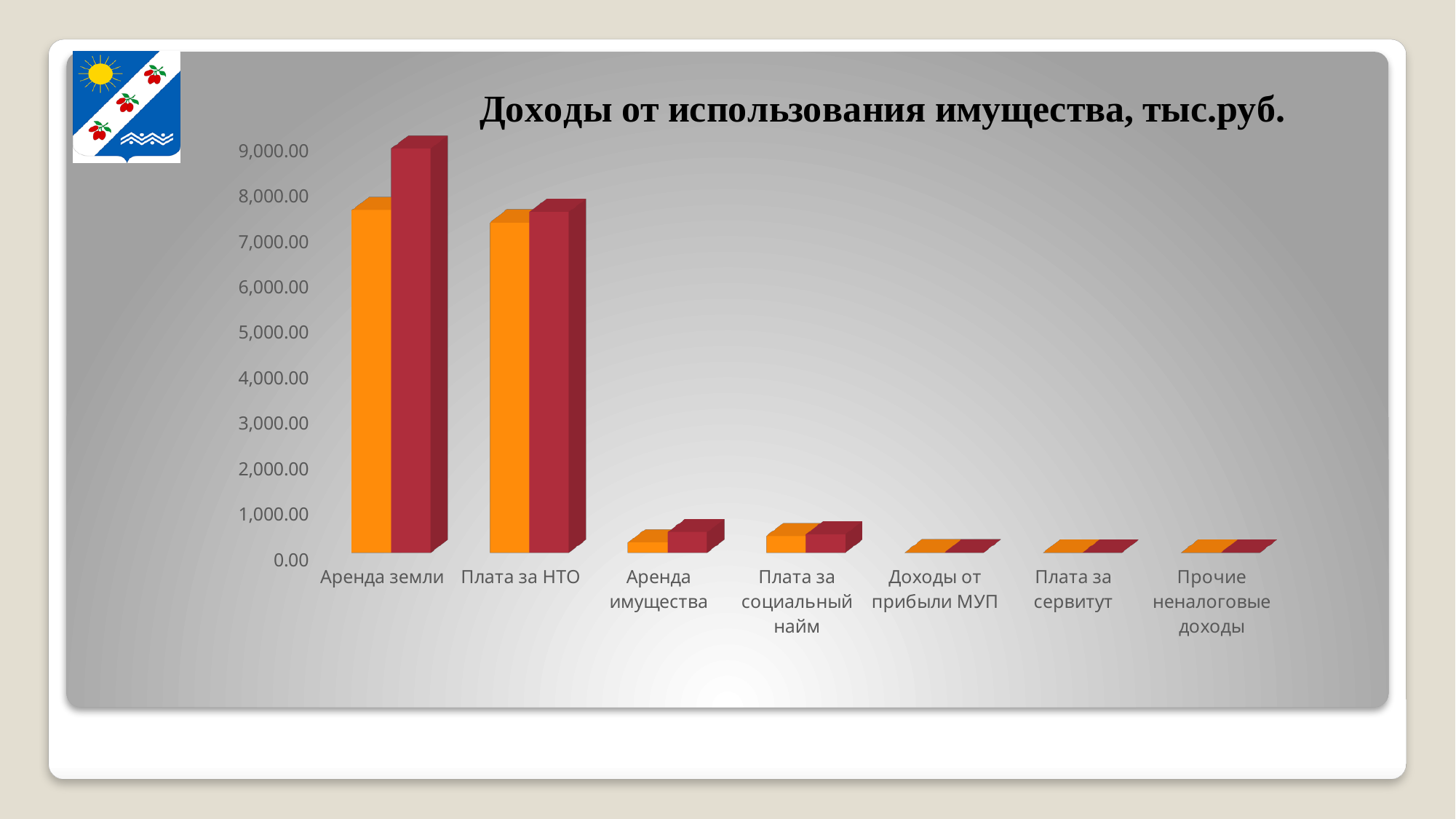
How many categories are shown on the x axis of the chart? 7 Which is larger: the red bar for Аренда земли or the red bar for Плата за НТО? Аренда земли Is the orange bar for Аренда земли greater or less than 7,000.00? greater Which category has the tallest red bar? Аренда земли How many bars are shown for each category in the chart? 2 Is the orange bar for Плата за социальный найм greater or less than 1,000.00? less What kind of chart is shown on the slide? Bar chart Which category has the tallest orange bar? Аренда земли Is the red bar for Аренда земли greater or less than 8,000.00? greater What is the title of the chart? Доходы от использования имущества, тыс.руб. Do the values generally rise or fall moving from left to right along the x axis? Fall